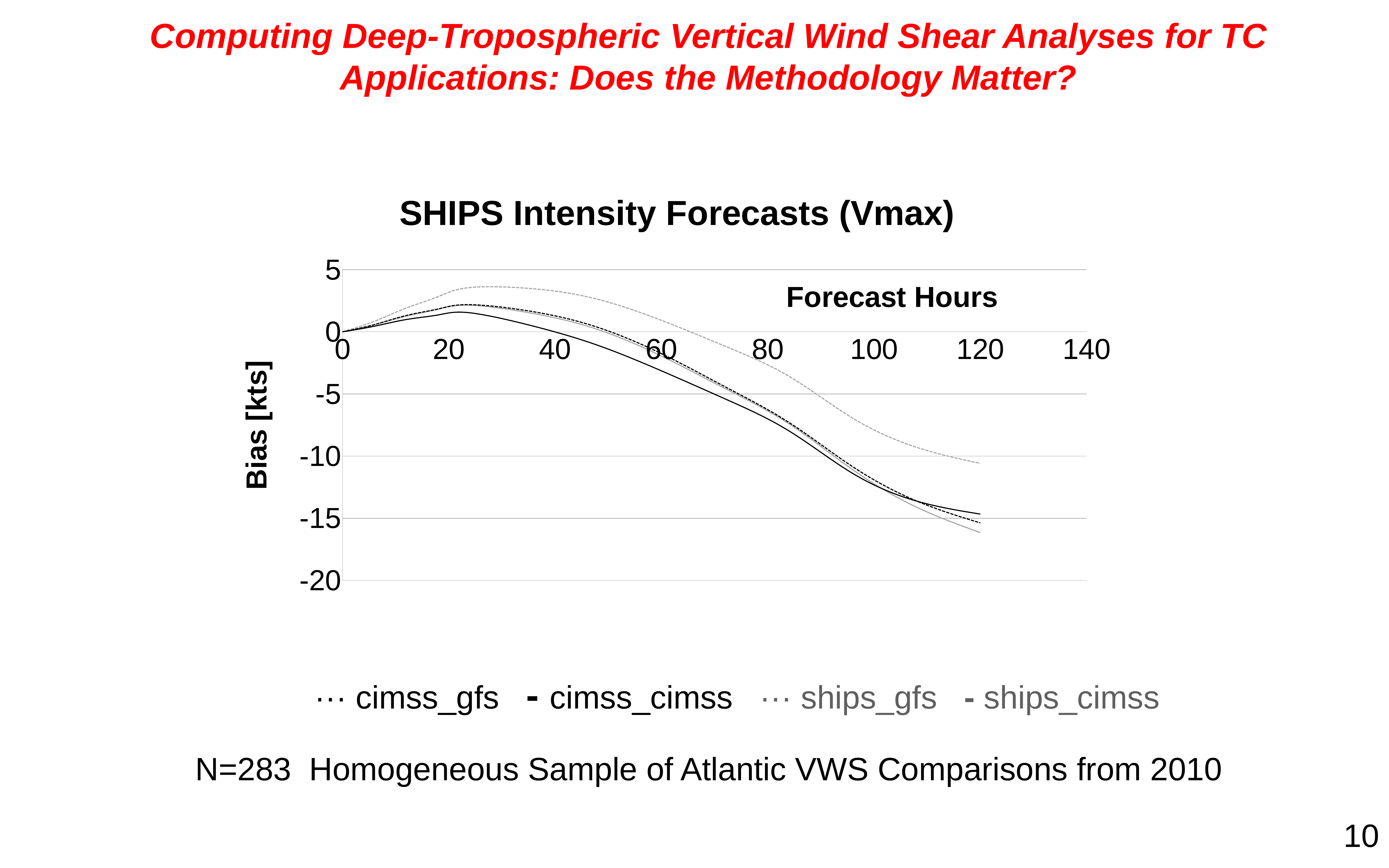
Do the bias values generally rise or fall from forecast hour 40 to forecast hour 120? fall Is the bias for cimss_cimss at forecast hour 120 greater or less than -15? greater What is the title of the chart? SHIPS Intensity Forecasts (Vmax) At forecast hour 80, which series has the larger bias, ships_gfs or cimss_cimss? ships_gfs Is the bias for ships_gfs at forecast hour 100 greater or less than -10? greater Is the bias for ships_cimss at forecast hour 120 greater or less than -15? less What kind of chart is shown on the slide? line chart How many series does the legend list? 4 Which series reaches the highest bias value anywhere on the chart? ships_gfs Which series has the highest bias at forecast hour 120? ships_gfs What is the bias value for all series at forecast hour 0? 0 What is the label of the y axis? Bias [kts]